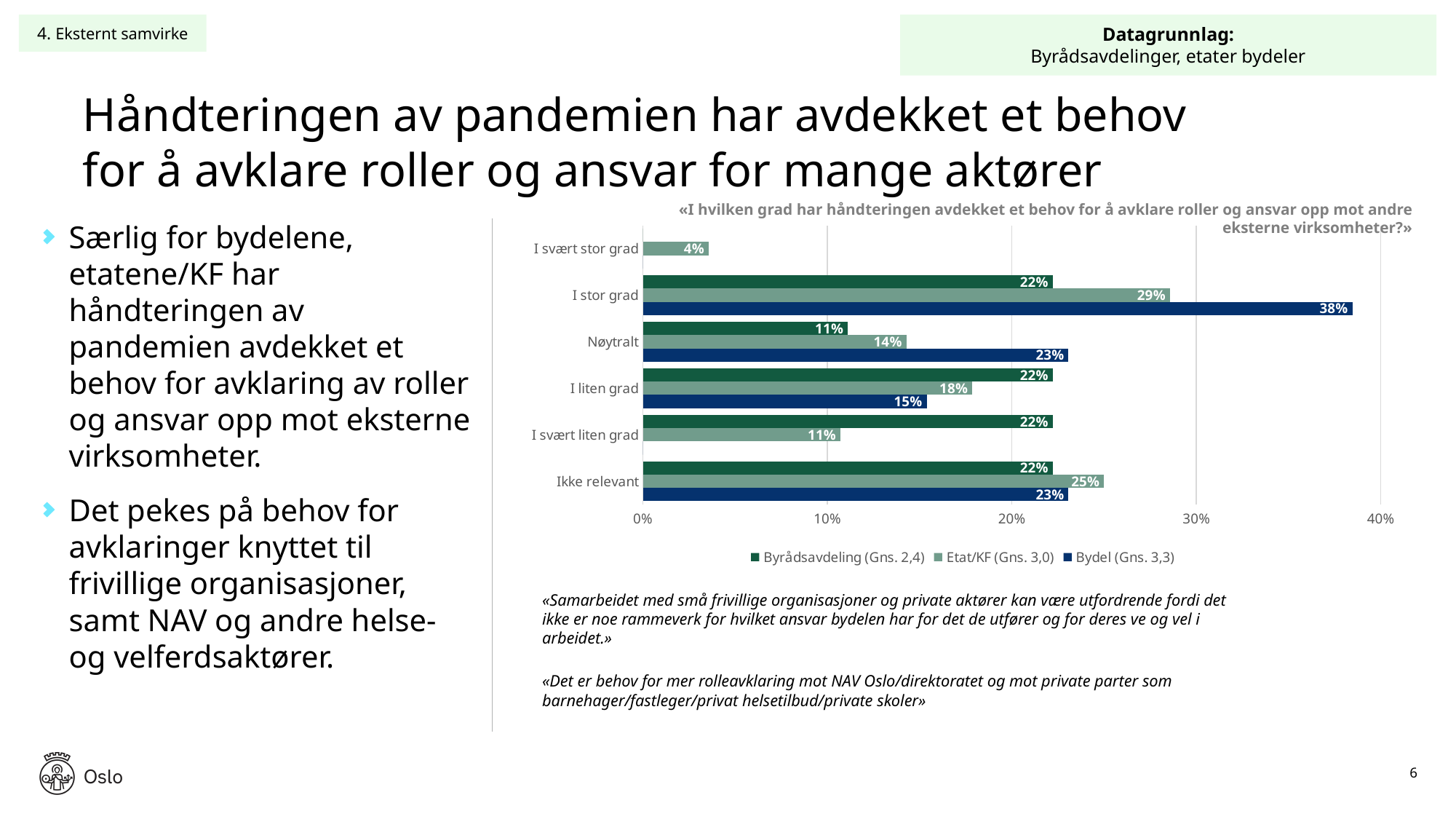
What is the difference between the Bydel and Byrådsavdeling values in the category 'I stor grad'? 16% What average (Gns.) is shown in the legend for the Bydel series? 3,3 What kind of chart is shown on the slide? bar chart Which category has the lowest value for the Etat/KF series? I svært stor grad What is the value for Bydel in the category 'I stor grad'? 38% How many categories are shown on the chart's vertical axis? 6 How many series does the chart legend list? 3 What is the value for Etat/KF in the category 'I svært stor grad'? 4% What is the value for Etat/KF in the category 'Ikke relevant'? 25% Which category has the highest value for the Bydel series? I stor grad In the category 'I liten grad', which is larger: the value for Byrådsavdeling or for Bydel? Byrådsavdeling What is the value for Byrådsavdeling in the category 'Nøytralt'? 11%